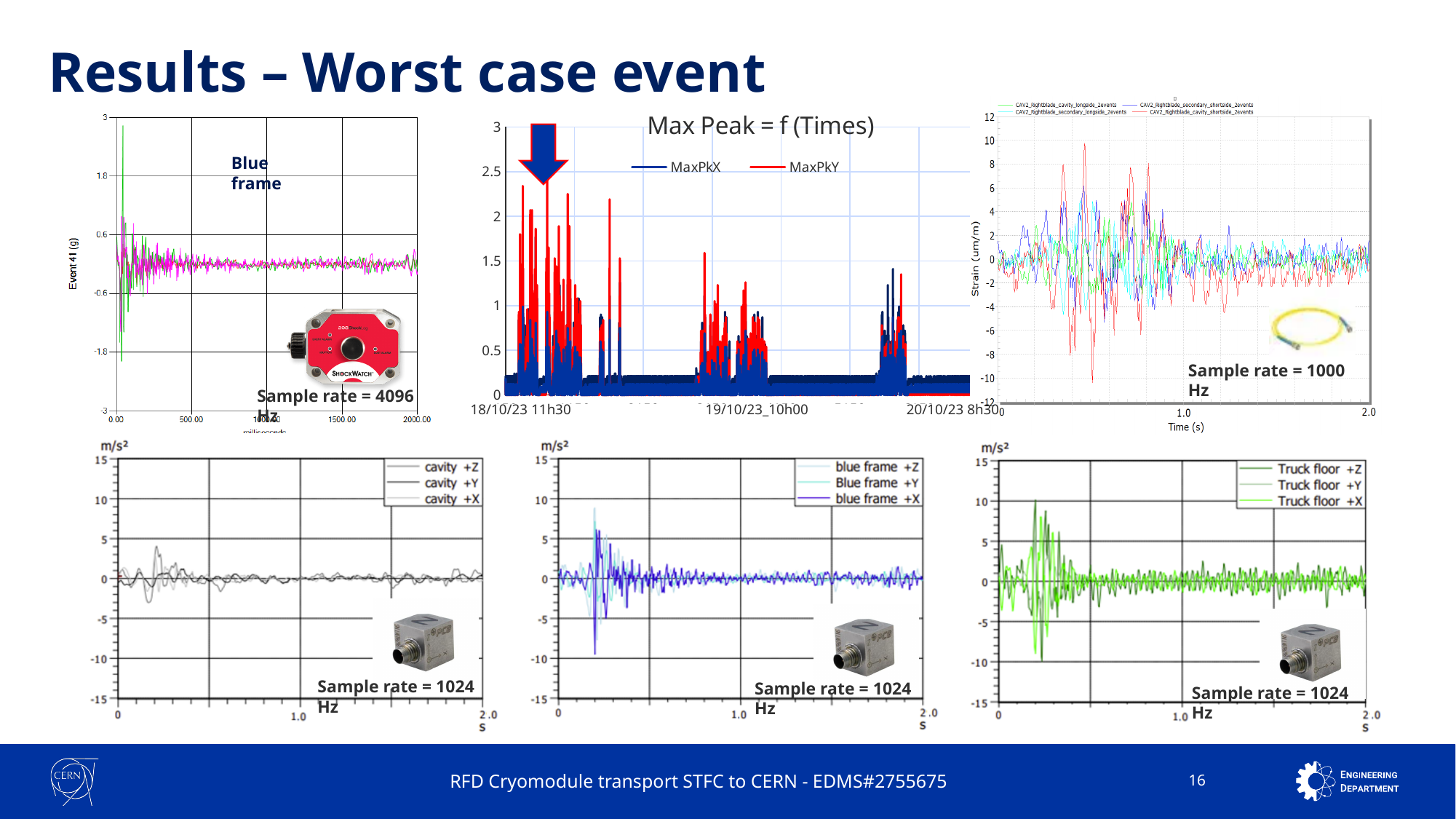
In the top-right strain chart, how many series does the legend list? 4 In the 'Max Peak = f (Times)' chart, how many series does the legend list? 2 What sample rate is stated for the top-left 'Event 41 (g)' chart? 4096 Hz In the bottom-left cavity chart, how many series does the legend list? 3 In the bottom-right 'Truck floor' chart, is the largest positive acceleration peak greater or less than 5 m/s²? greater What kind of chart is the 'Max Peak = f (Times)' chart? Line chart What sample rate is stated for the top-right strain chart? 1000 Hz In the top-right strain chart, is the largest positive strain peak greater or less than 8 um/m? greater What sample rate is stated for the bottom-middle 'blue frame' chart? 1024 Hz In the 'Max Peak = f (Times)' chart, is the highest MaxPkY peak greater or less than 2? greater In the 'Max Peak = f (Times)' chart, which colour represents MaxPkY? Red In the 'Max Peak = f (Times)' chart, what are the two legend entries? MaxPkX and MaxPkY